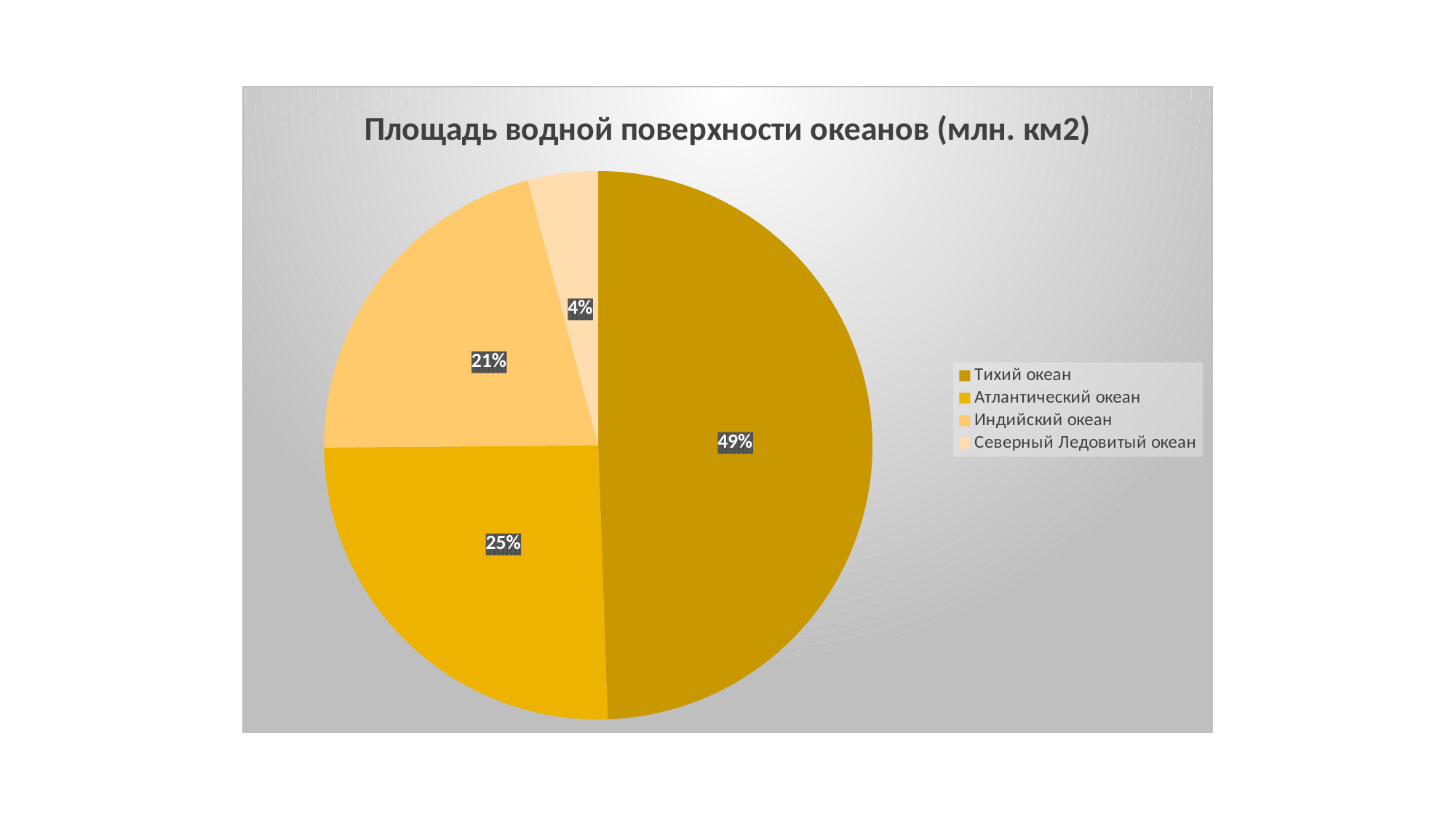
What is the difference in percentage points between the shares of Тихий океан and Атлантический океан? 24 What share of the pie does Тихий океан have? 49% How many entries does the legend list? 4 What share of the pie does Северный Ледовитый океан have? 4% What kind of chart is shown on the slide? pie chart Which has a larger share, Атлантический океан or Индийский океан? Атлантический океан Which ocean has the largest slice of the pie? Тихий океан What share of the pie does Индийский океан have? 21% What is the title of the chart? Площадь водной поверхности океанов (млн. км2) Which ocean has the smallest slice of the pie? Северный Ледовитый океан How many slices does the pie chart have? 4